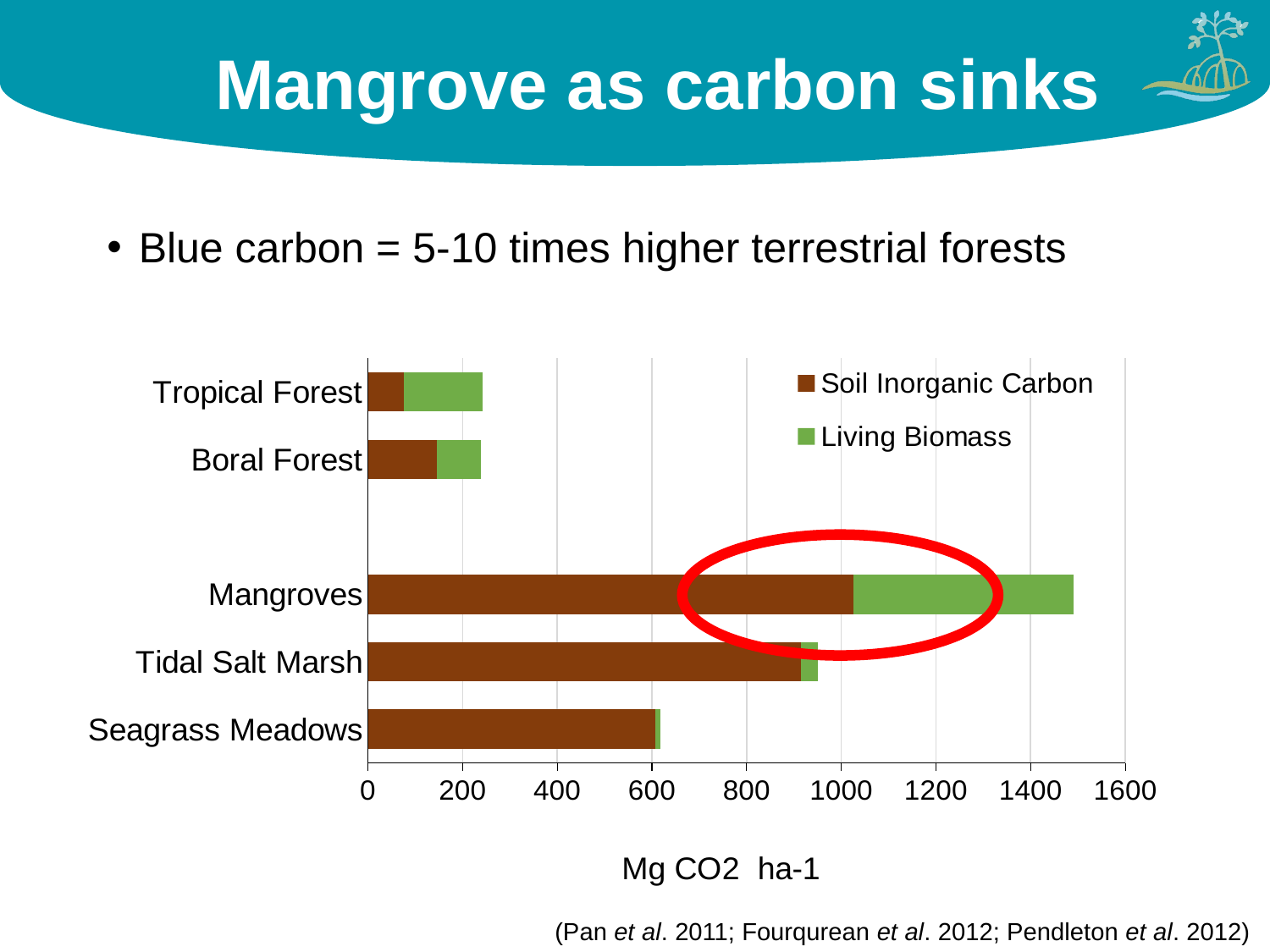
Is the total value for Seagrass Meadows greater or less than 800? less How many series does the legend list? 2 What is the label on the horizontal axis of the chart? Mg CO2 ha-1 Is the total value for Mangroves greater or less than 1400? greater Which category has the highest total value on the chart? Mangroves Which has a larger total value, Mangroves or Tidal Salt Marsh? Mangroves Is the total value for Tropical Forest greater or less than 400? less How many categories are plotted on the chart? 5 What kind of chart is shown on the slide? Stacked bar chart Which series is shown in green in the legend? Living Biomass Which has a larger total value, Tidal Salt Marsh or Seagrass Meadows? Tidal Salt Marsh